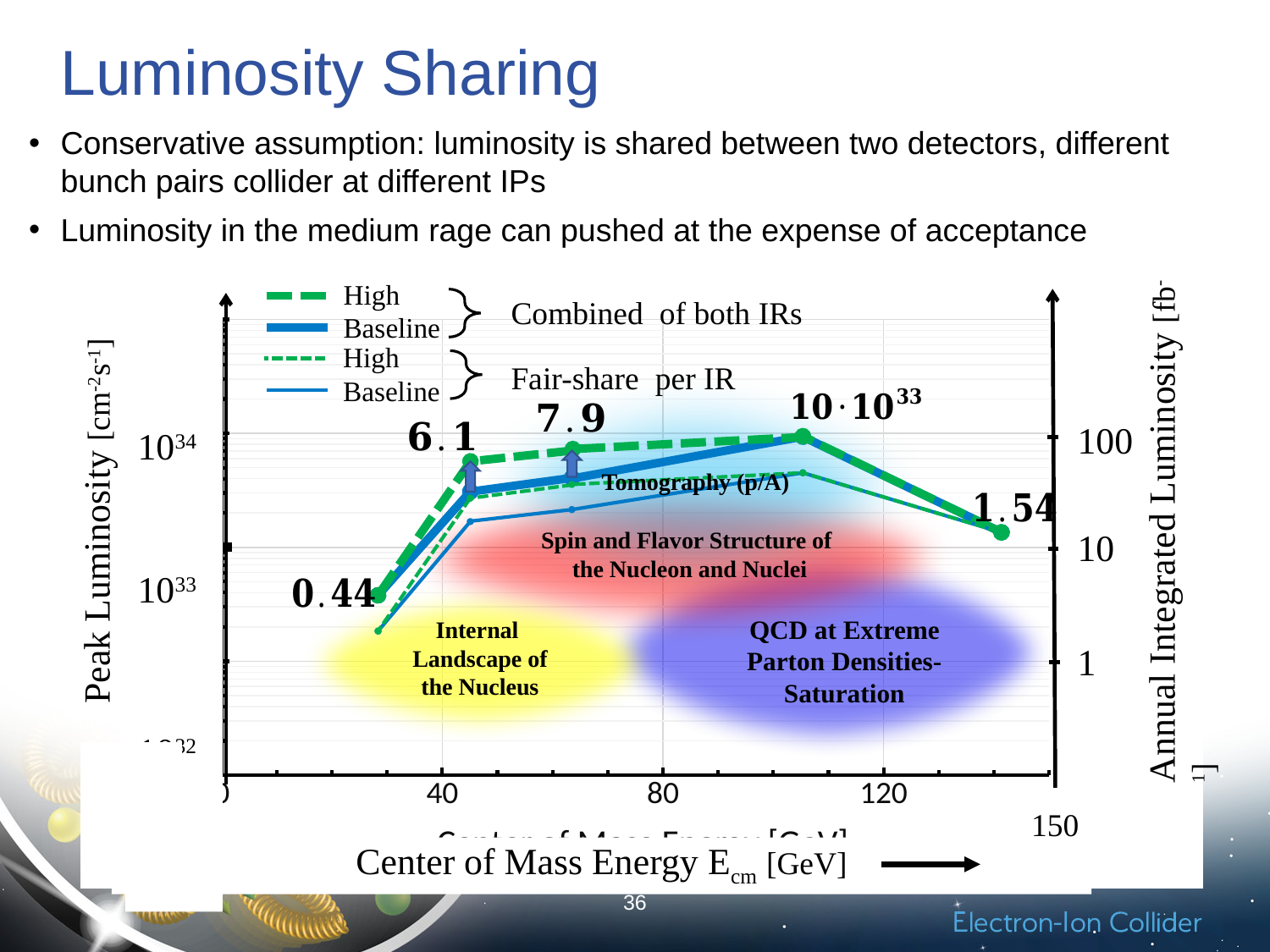
Do the plotted values rise or fall as the center of mass energy increases from 40 GeV to about 105 GeV? rise What kind of chart is shown on the slide? line chart What data label is printed at the rightmost point of the chart, near 140 GeV? 1.54 What is the difference between the labeled values 7.9 and 6.1? 1.8 What is the title of the x axis of the chart? Center of Mass Energy E_cm [GeV] How many series does the chart legend list? 4 How many data labels are printed on the chart? 5 What is the largest data label printed on the chart? 10·10^33 Is the peak luminosity at the highest point of the chart greater or less than 10^33? greater What is the smallest data label printed on the chart? 0.44 What data label is printed at the point near 45 GeV on the thick dashed High line? 6.1 Which labeled value is larger, 7.9 or 6.1? 7.9